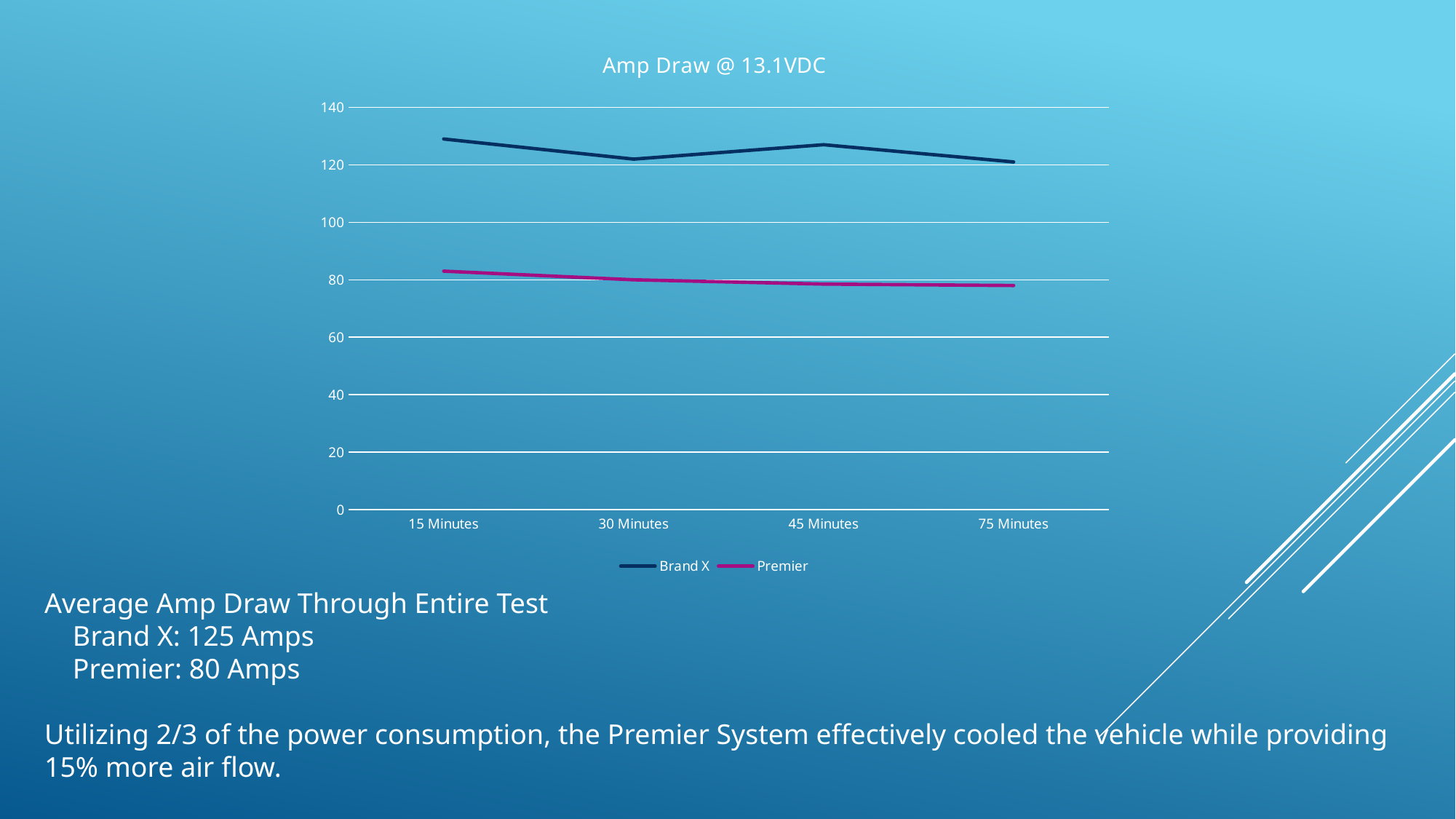
What kind of chart is shown on the slide? line chart Is the value for Brand X at 45 Minutes greater or less than 140? less Is the value for Premier at 15 Minutes greater or less than 80? greater How many series does the chart's legend list? 2 Is the value for Brand X at 15 Minutes greater or less than 120? greater At which time point does the Premier series reach its highest value? 15 Minutes Does the Premier series rise or fall from 15 Minutes to 75 Minutes? fall How many time points are plotted along the x axis? 4 What is the title of the chart? Amp Draw @ 13.1VDC Which series has the higher value at 30 Minutes, Brand X or Premier? Brand X Which series is drawn in the magenta line? Premier